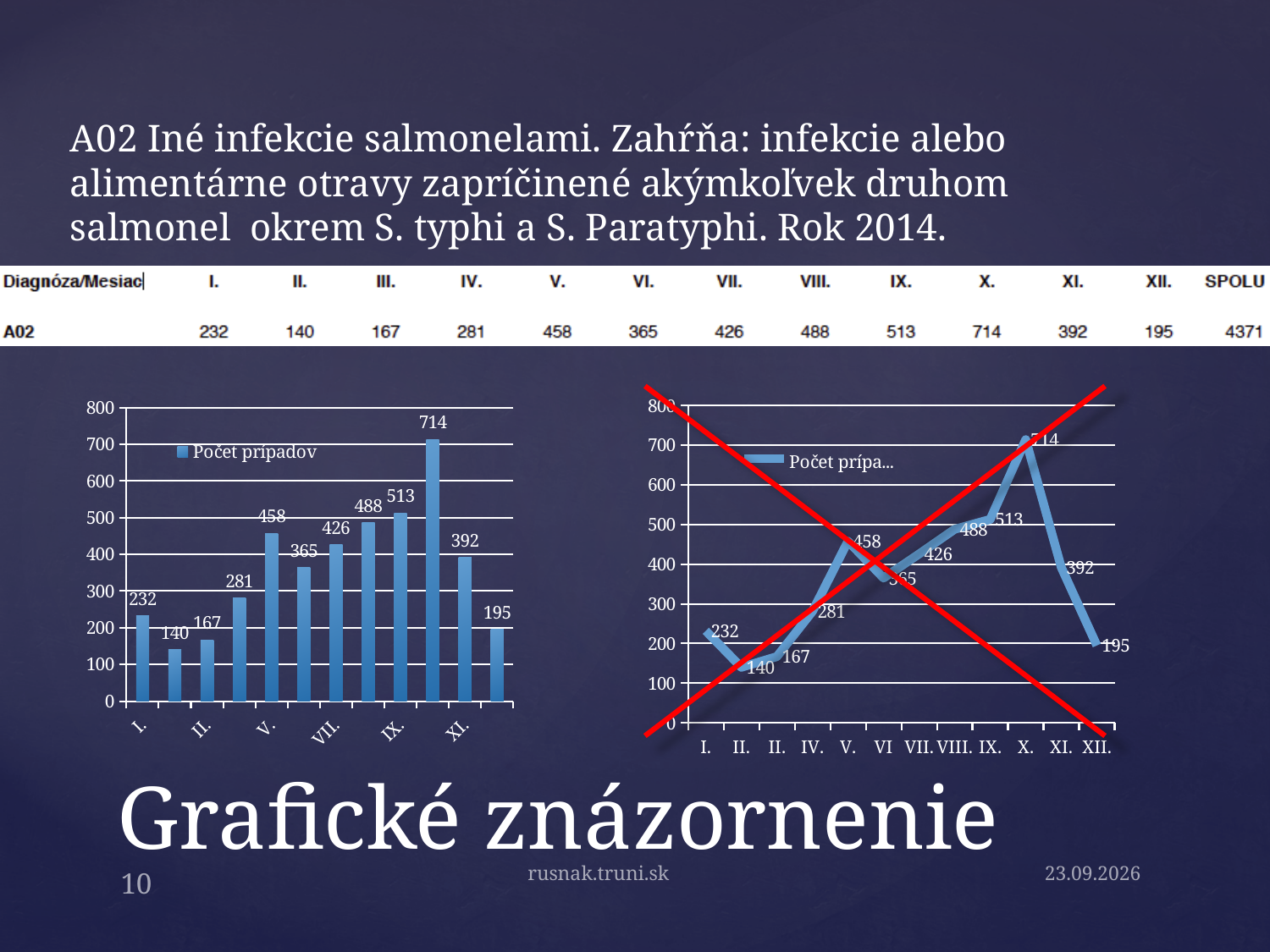
In the line chart on the right, which is larger, the value for month IX. or the value for month XI.? IX. In the line chart on the right, what is the value for month XII.? 195 In the bar chart on the left, what is the difference between the highest value (714) and the lowest value (140)? 574 In the bar chart on the left, what is the value for month I.? 232 In the bar chart on the left, what is the name of the series shown in the legend? Počet prípadov In the line chart on the right, what is the value for month V.? 458 In the bar chart on the left, which month has the highest number of cases? X. In the bar chart on the left, what type of chart is it? bar chart In the bar chart on the left, what is the value of the tallest bar? 714 In the bar chart on the left, which month has the lowest number of cases? II. In the chart on the right, what type of chart is it? line chart In the bar chart on the left, how many bars are plotted? 12